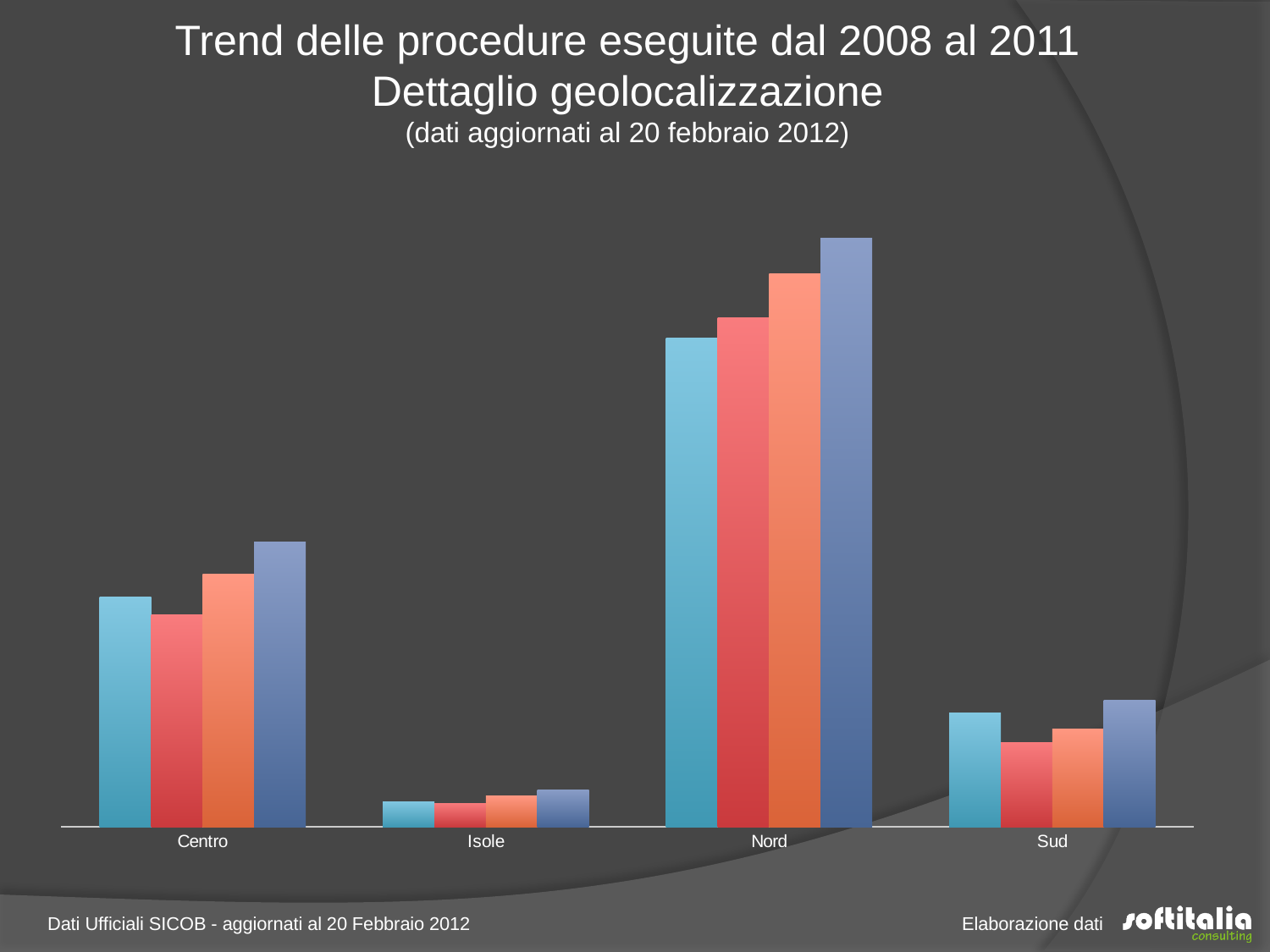
Which category has taller bars, Sud or Isole? Sud How many categories are shown on the x axis of the chart? 4 Within the Centro group, which bar is the tallest: the first, second, third or fourth? fourth Within the Nord group, do the bars rise or fall from left to right? rise How many bars are shown for each category in the chart? 4 Which category has taller bars, Centro or Sud? Centro Which category has the shortest bars in the chart? Isole What kind of chart is shown on the slide? bar chart What is the main title of the chart on the slide? Trend delle procedure eseguite dal 2008 al 2011 Which category has the tallest bars in the chart? Nord Which category has taller bars, Nord or Centro? Nord According to the subtitle, up to what date are the chart's data updated? 20 febbraio 2012